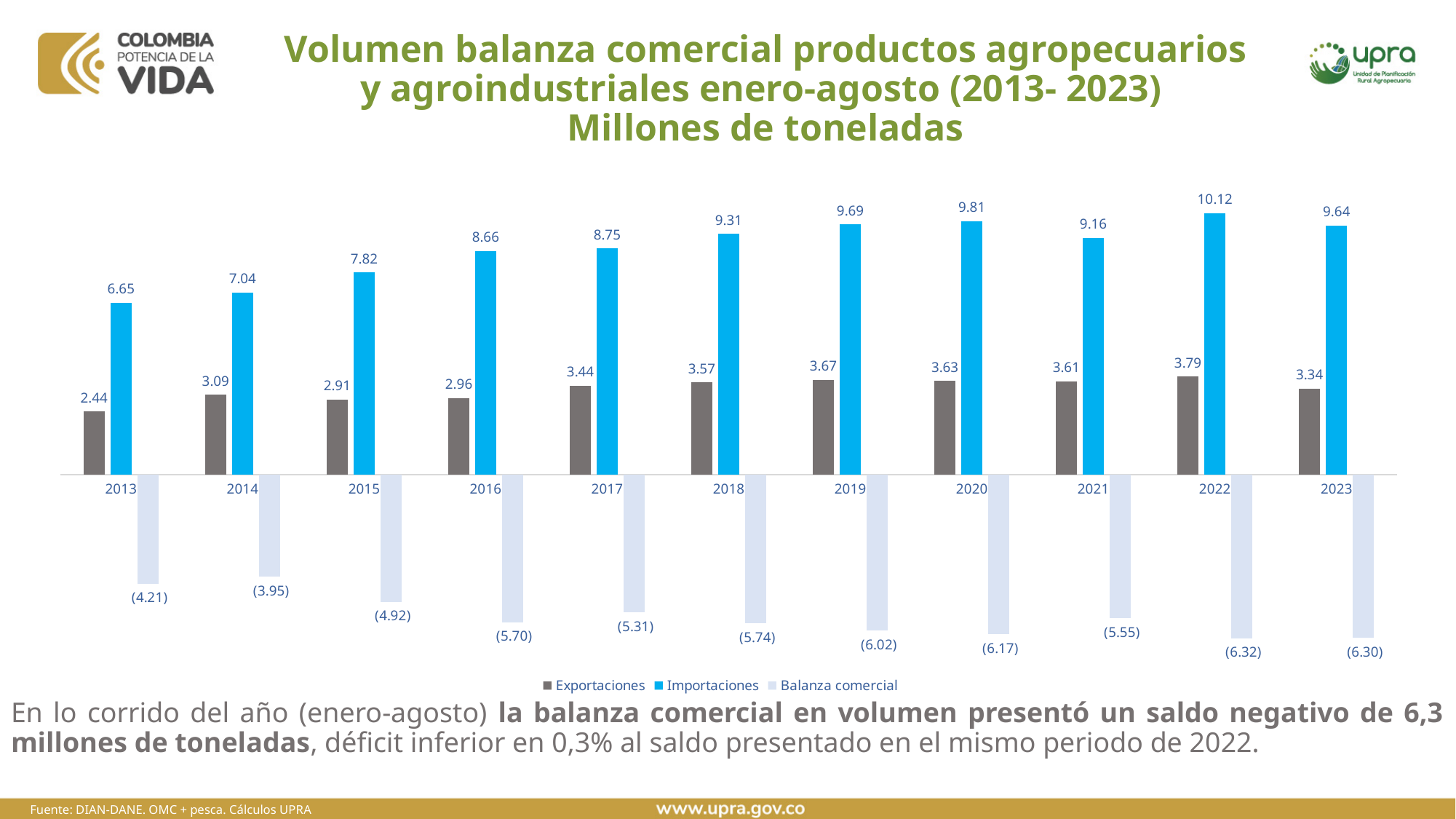
Which year has the highest Importaciones value? 2022 How many series does the legend list? 3 What kind of chart is shown on the slide? Bar chart How many years are shown on the x axis? 11 Do the Importaciones values generally rise or fall from 2013 to 2020? Rise Which year has the lowest Exportaciones value? 2013 What colour are the Importaciones bars? Blue What is the value of Exportaciones for 2013? 2.44 What is the value of Balanza comercial for 2023? (6.30) Which is larger, Exportaciones in 2022 or Exportaciones in 2023? Exportaciones in 2022 What is the difference between Importaciones and Exportaciones in 2019? 6.02 What is the value of Importaciones for 2022? 10.12